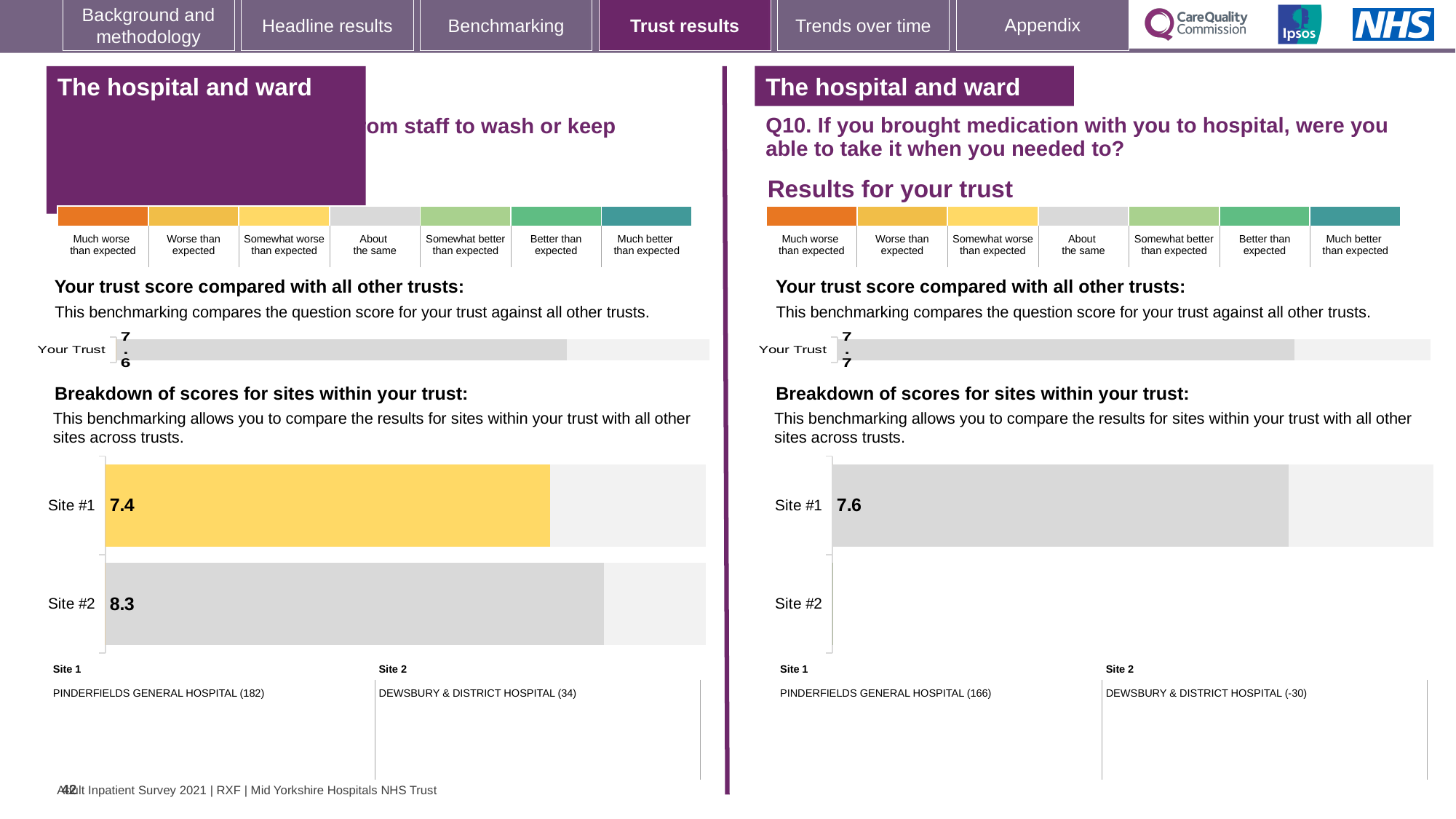
What type of chart is used for the breakdown of scores for sites within your trust on the left-hand side of the slide? Bar chart In the Q10 chart on the right-hand side of the slide, what is the score shown for Site #1 in the breakdown of scores for sites within your trust? 7.6 On the left-hand side of the slide, what is the score shown for Site #1 in the breakdown of scores for sites within your trust? 7.4 In the Q10 chart on the right-hand side of the slide, what is the 'Your Trust' score shown in the trust score comparison bar? 7.7 On the left-hand side of the slide, what is the difference between the Site #2 score and the Site #1 score in the site breakdown chart? 0.9 On the left-hand side of the slide, which site has the higher score in the breakdown of scores for sites within your trust? Site #2 On the left-hand side of the slide, what colour is the Site #1 bar in the site breakdown chart? Yellow On the left-hand side of the slide, what is the 'Your Trust' score shown in the trust score comparison bar? 7.6 Which site has a higher score: Site #1 on the left-hand chart or Site #1 on the right-hand Q10 chart? Site #1 on the right-hand Q10 chart In the Q10 chart on the right-hand side of the slide, which site has no bar plotted in the site breakdown chart? Site #2 On the left-hand side of the slide, what is the score shown for Site #2 in the breakdown of scores for sites within your trust? 8.3 In the Q10 chart on the right-hand side of the slide, how many sites are listed in the breakdown of scores for sites within your trust? 2